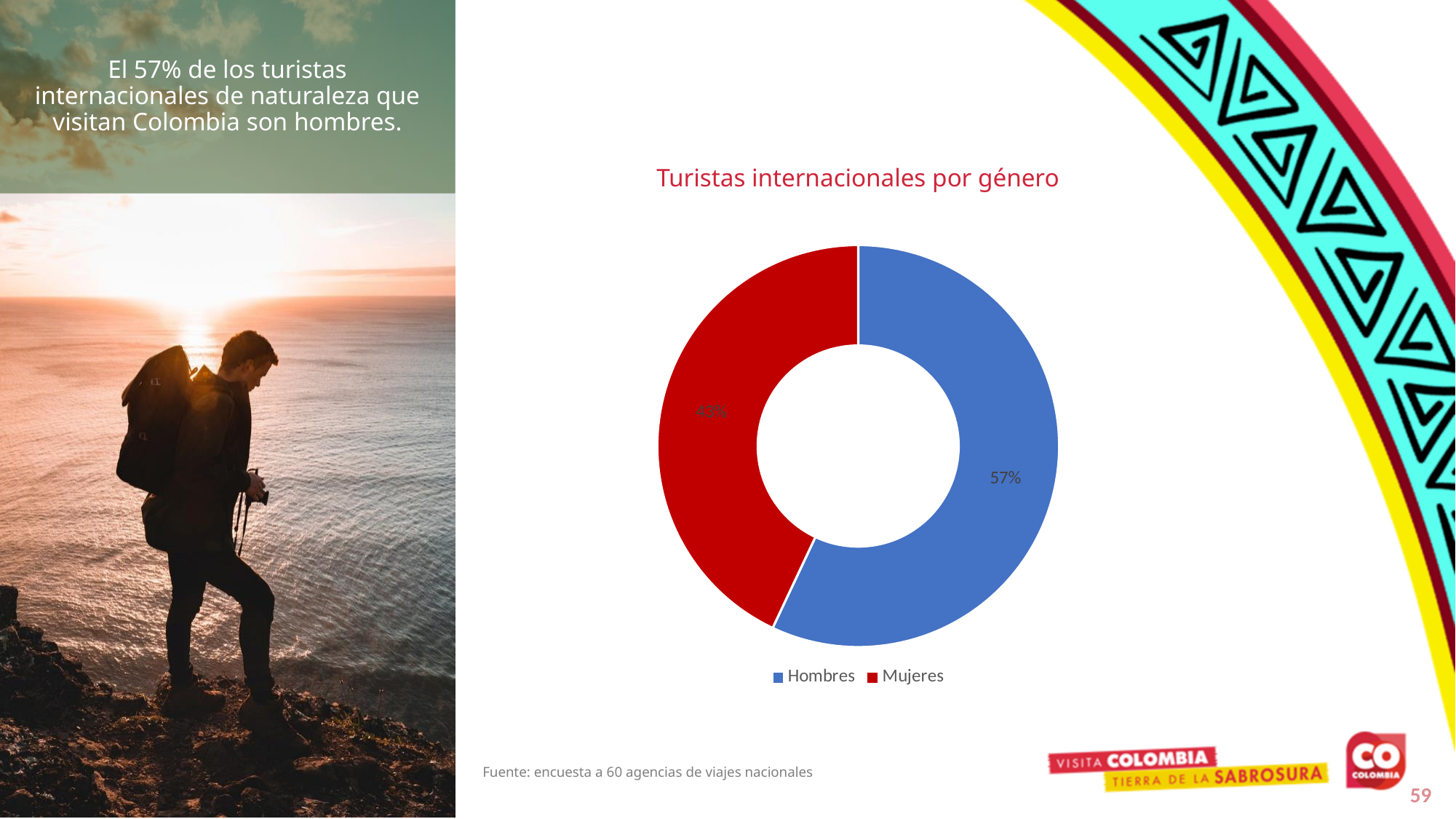
What is the title of the chart? Turistas internacionales por género Which category has the largest share of the chart? Hombres How many entries does the legend list? 2 What colour represents Mujeres in the chart? red Which category has the smallest share of the chart? Mujeres How many categories does the chart show? 2 What is the share of the chart taken by the Hombres slice? 57% What percentage of international tourists are Mujeres according to the chart? 43% What kind of chart is shown on the slide? donut chart By how many percentage points does the Hombres share exceed the Mujeres share? 14 percentage points What percentage of international tourists are Hombres according to the chart? 57% Which is larger, the share for Hombres or the share for Mujeres? Hombres